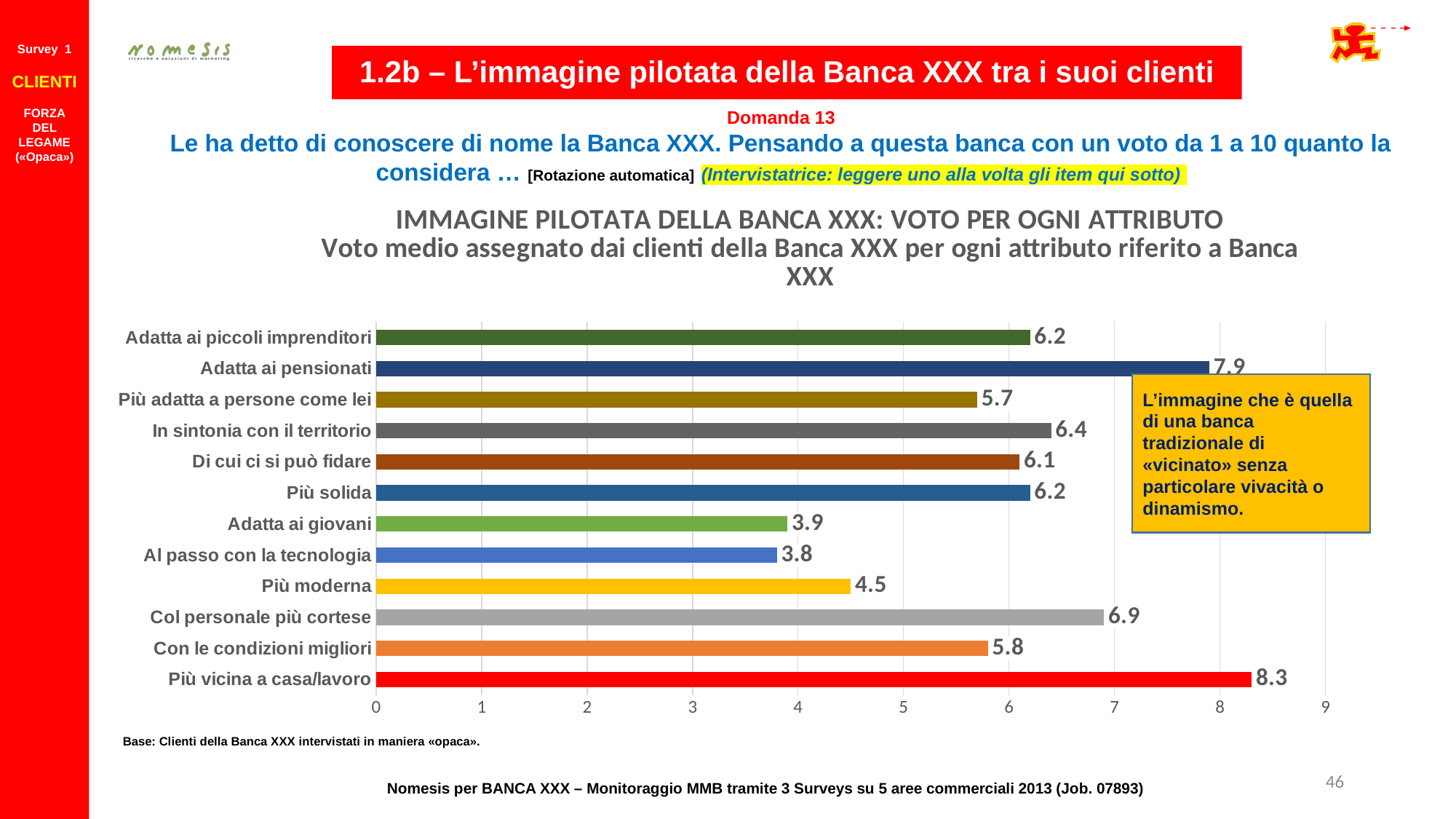
What is the value for "Al passo con la tecnologia"? 3.8 Which attribute has the lowest value? Al passo con la tecnologia What is the difference between the values for "Adatta ai pensionati" and "Più adatta a persone come lei"? 2.2 What is the value for "Col personale più cortese"? 6.9 Is the value for "Più moderna" greater or less than 5? less Which attribute has the highest value? Più vicina a casa/lavoro What is the difference between the values for "Più vicina a casa/lavoro" and "Adatta ai giovani"? 4.4 What is the value for "Adatta ai pensionati"? 7.9 Which is larger, the value for "In sintonia con il territorio" or the value for "Di cui ci si può fidare"? In sintonia con il territorio What kind of chart is shown on the slide? Bar chart What is the highest value shown on the x axis of the chart? 9 How many attributes are shown in the chart? 12